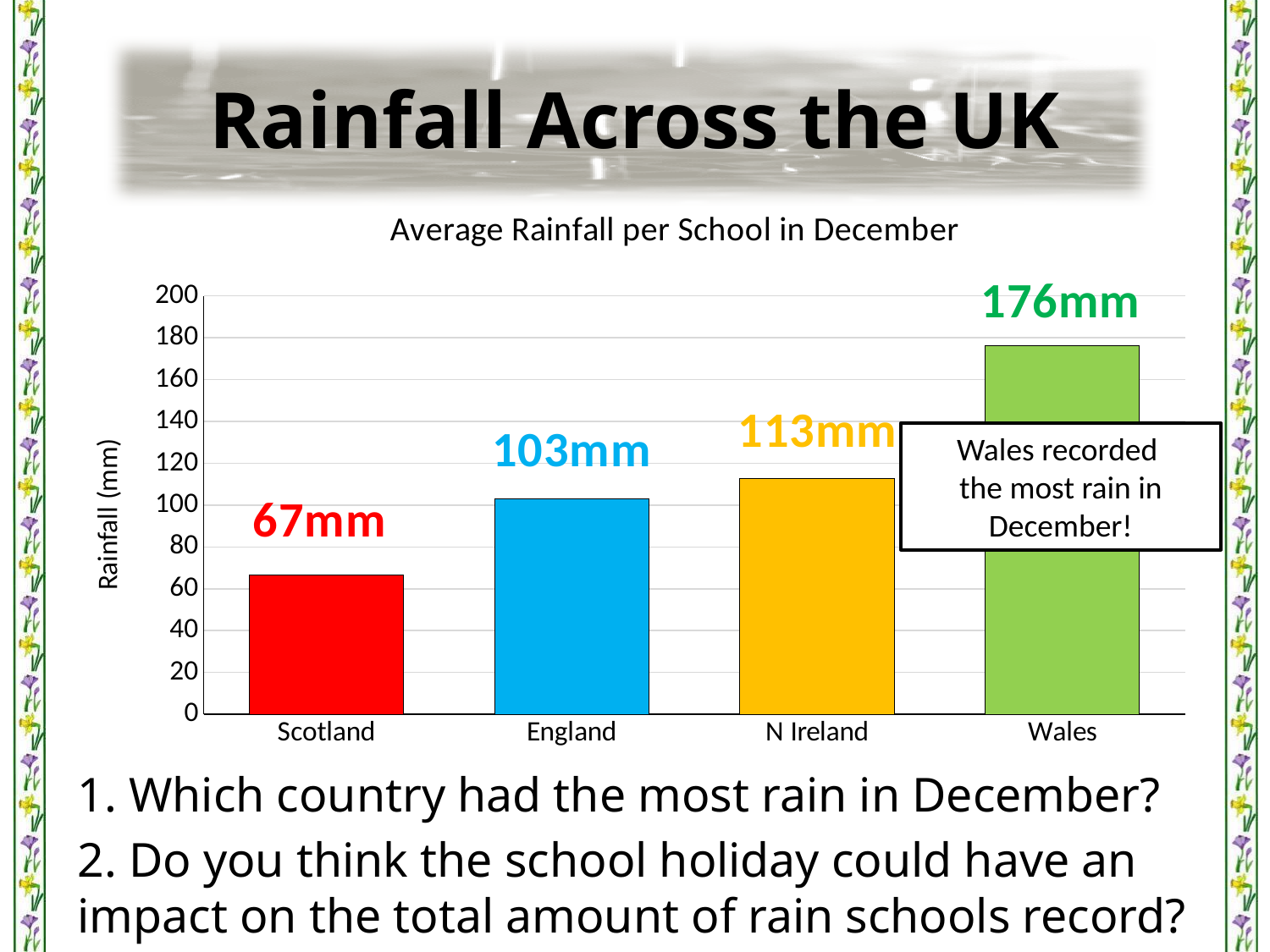
Which country has the lowest average rainfall? Scotland What is the average rainfall for Wales? 176mm Which has more rainfall, England or N Ireland? N Ireland What is the average rainfall for England? 103mm What kind of chart is shown? Bar chart What is the difference in rainfall between Wales and Scotland? 109mm What is the average rainfall for N Ireland? 113mm Which country has the highest average rainfall? Wales What is the difference in rainfall between N Ireland and England? 10mm What is the title of the chart? Average Rainfall per School in December What is the average rainfall for Scotland? 67mm How many countries are shown on the chart? 4